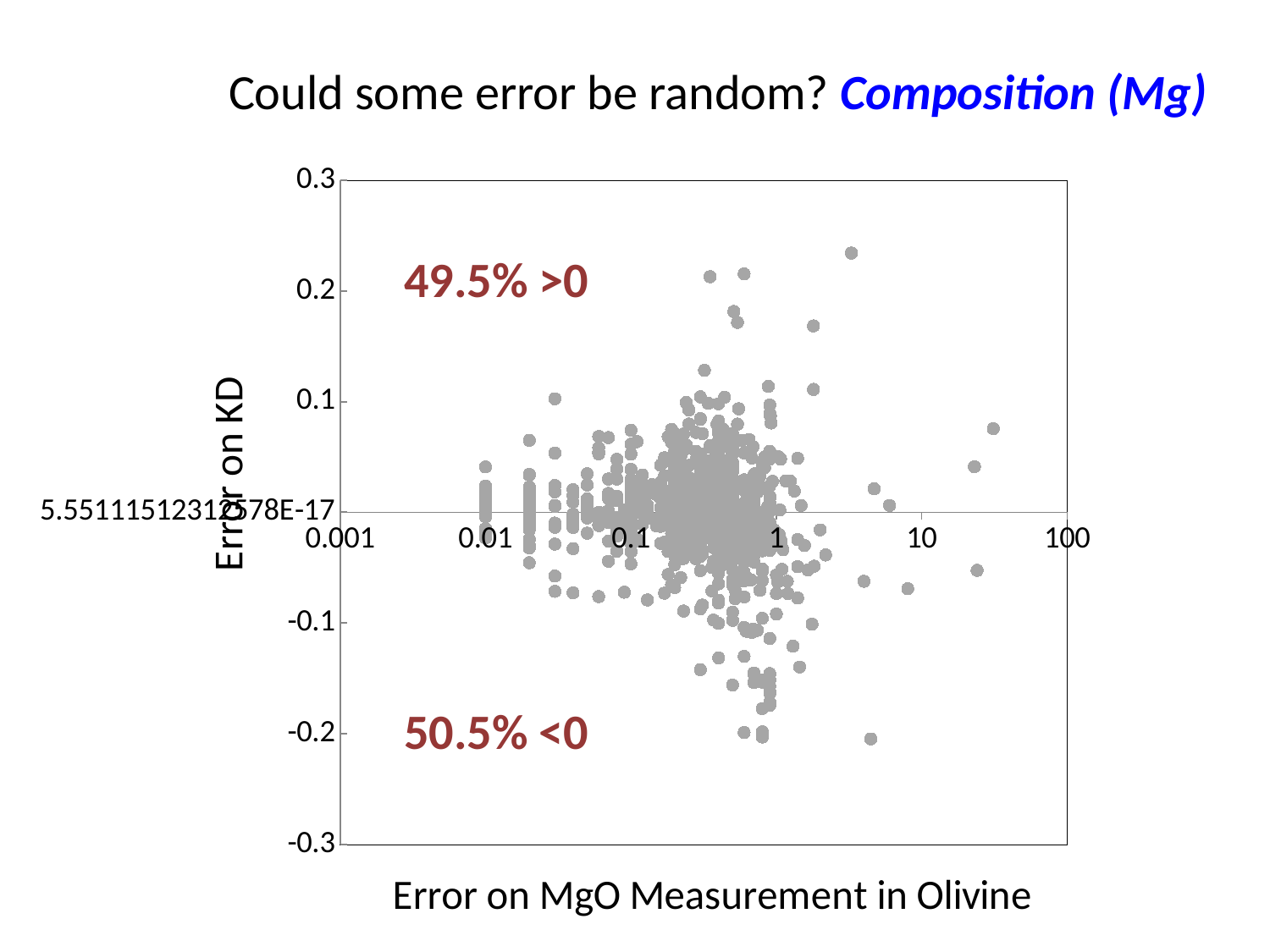
According to the annotation on the chart, what percentage of points have an error on KD less than 0? 50.5% Is the largest Error on MgO Measurement value plotted greater or less than 10? greater What is the title of the x axis of the chart? Error on MgO Measurement in Olivine Which group of points is larger according to the annotations: those with error on KD above 0 or those below 0? below 0 (50.5%) What is the maximum value shown on the y axis of the chart? 0.3 What is the maximum value shown on the x axis of the chart? 100 Is the lowest Error on KD value plotted greater or less than -0.1? less According to the annotation on the chart, what percentage of points have an error on KD greater than 0? 49.5% What is the difference between the percentage of points below 0 and the percentage above 0, as annotated on the chart? 1.0% What kind of chart is shown on the slide? scatter plot Is the highest Error on KD value plotted greater or less than 0.2? greater What is the title of the y axis of the chart? Error on KD